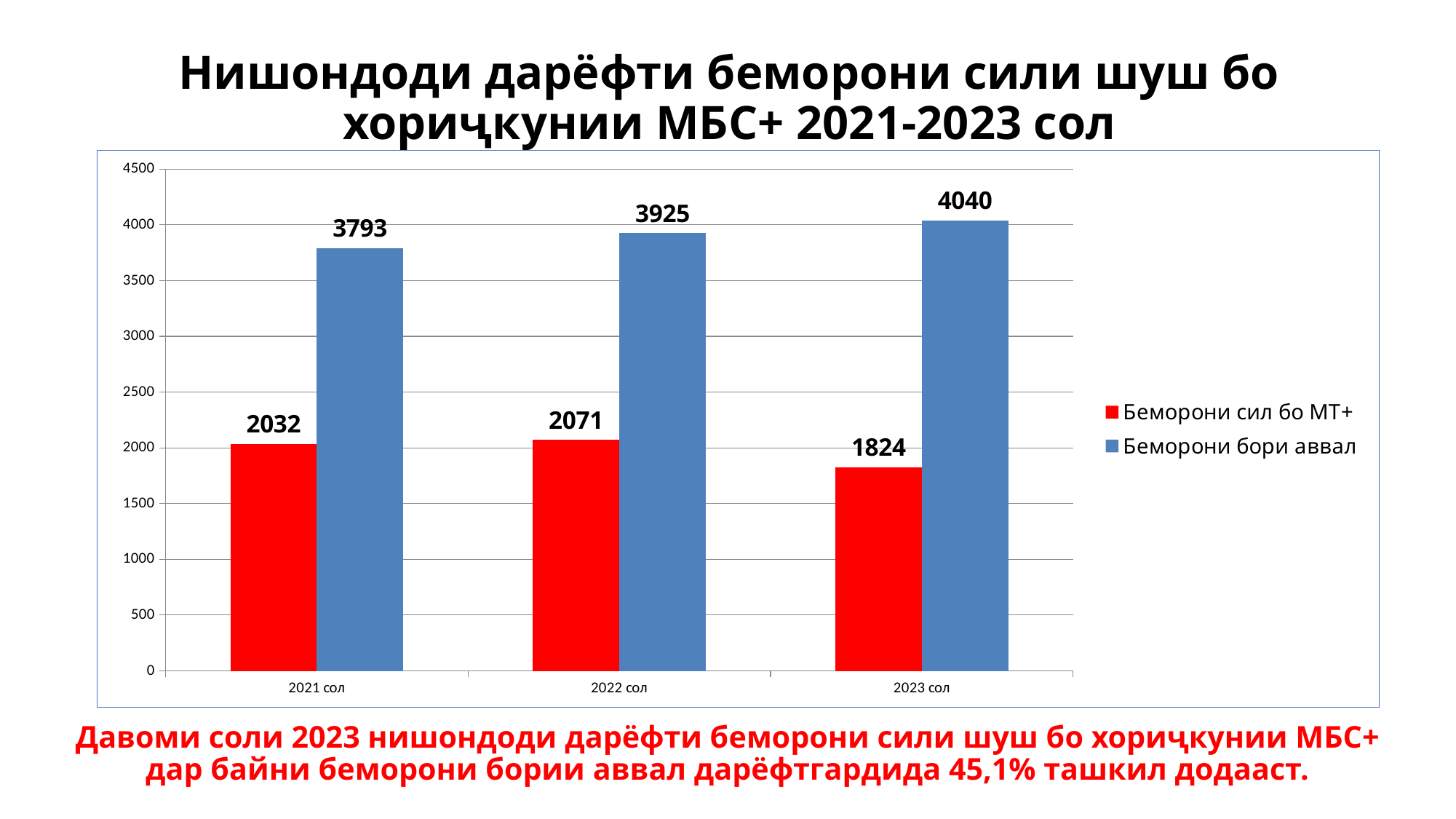
What is the value for "Беморони сил бо МТ+" in 2021 сол? 2032 In which year is the value for "Беморони бори аввал" highest? 2023 сол What is the value for "Беморони сил бо МТ+" in 2023 сол? 1824 What is the difference between the "Беморони бори аввал" value and the "Беморони сил бо МТ+" value in 2022 сол? 1854 How many series does the legend list? 2 Is the value for "Беморони бори аввал" in 2023 сол greater or less than 4000? greater What is the value for "Беморони бори аввал" in 2023 сол? 4040 How many years are shown on the x axis? 3 What is the value for "Беморони бори аввал" in 2022 сол? 3925 Which is larger in 2021 сол: "Беморони сил бо МТ+" or "Беморони бори аввал"? Беморони бори аввал In which year is the value for "Беморони сил бо МТ+" lowest? 2023 сол What kind of chart is shown on the slide? bar chart